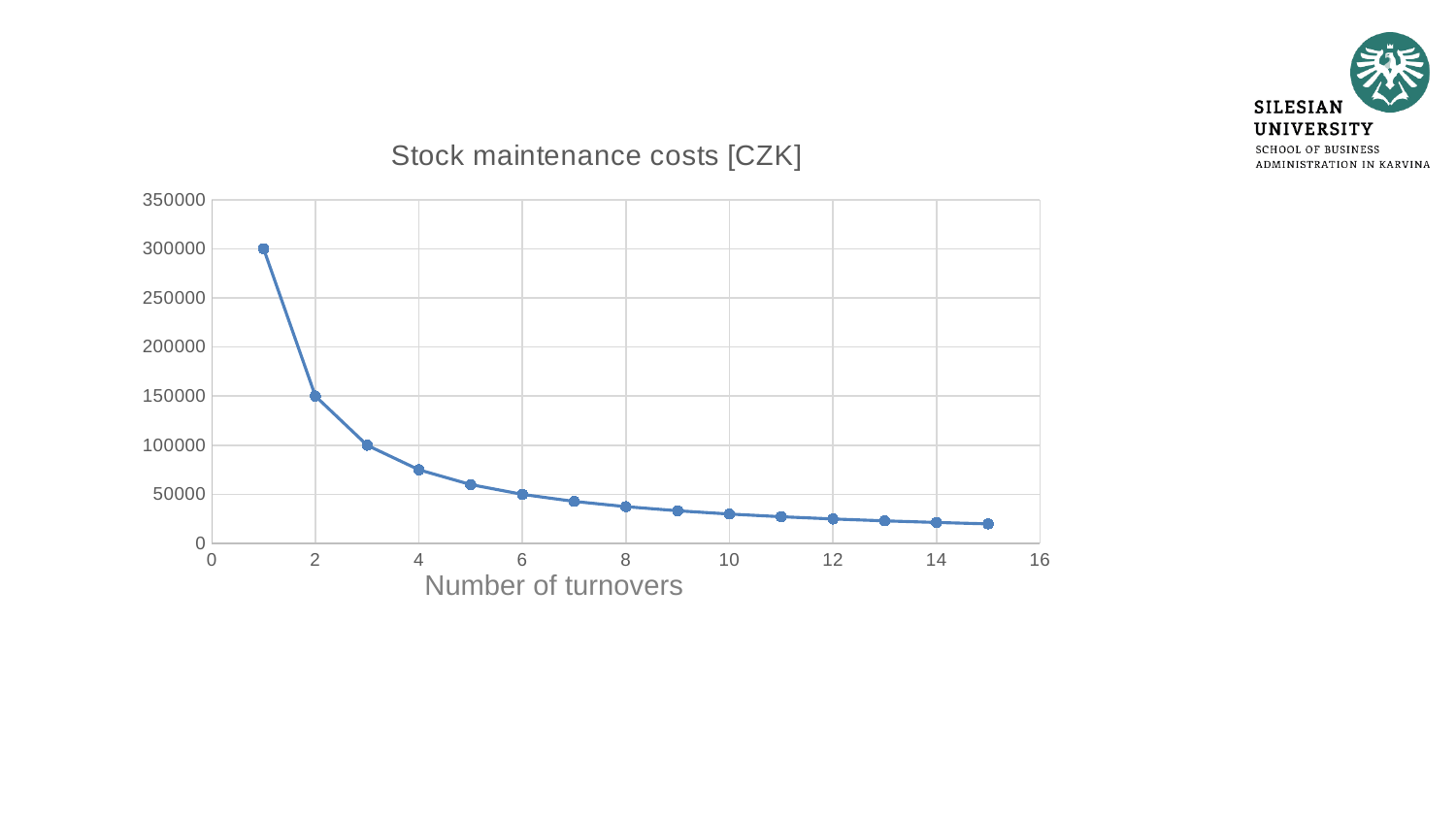
Do the stock maintenance costs rise or fall as the number of turnovers increases? fall What is the title of the chart? Stock maintenance costs [CZK] At which number of turnovers is the stock maintenance cost lowest? 15 What is the label of the x axis? Number of turnovers What is the stock maintenance cost at 3 turnovers? 100000 At which number of turnovers is the stock maintenance cost highest? 1 What is the stock maintenance cost at 2 turnovers? 150000 What is the stock maintenance cost at 6 turnovers? 50000 What kind of chart is shown on the slide? line chart How many data points are plotted on the chart? 15 Is the value for 4 turnovers greater or less than 50000? greater What is the stock maintenance cost at 1 turnover? 300000